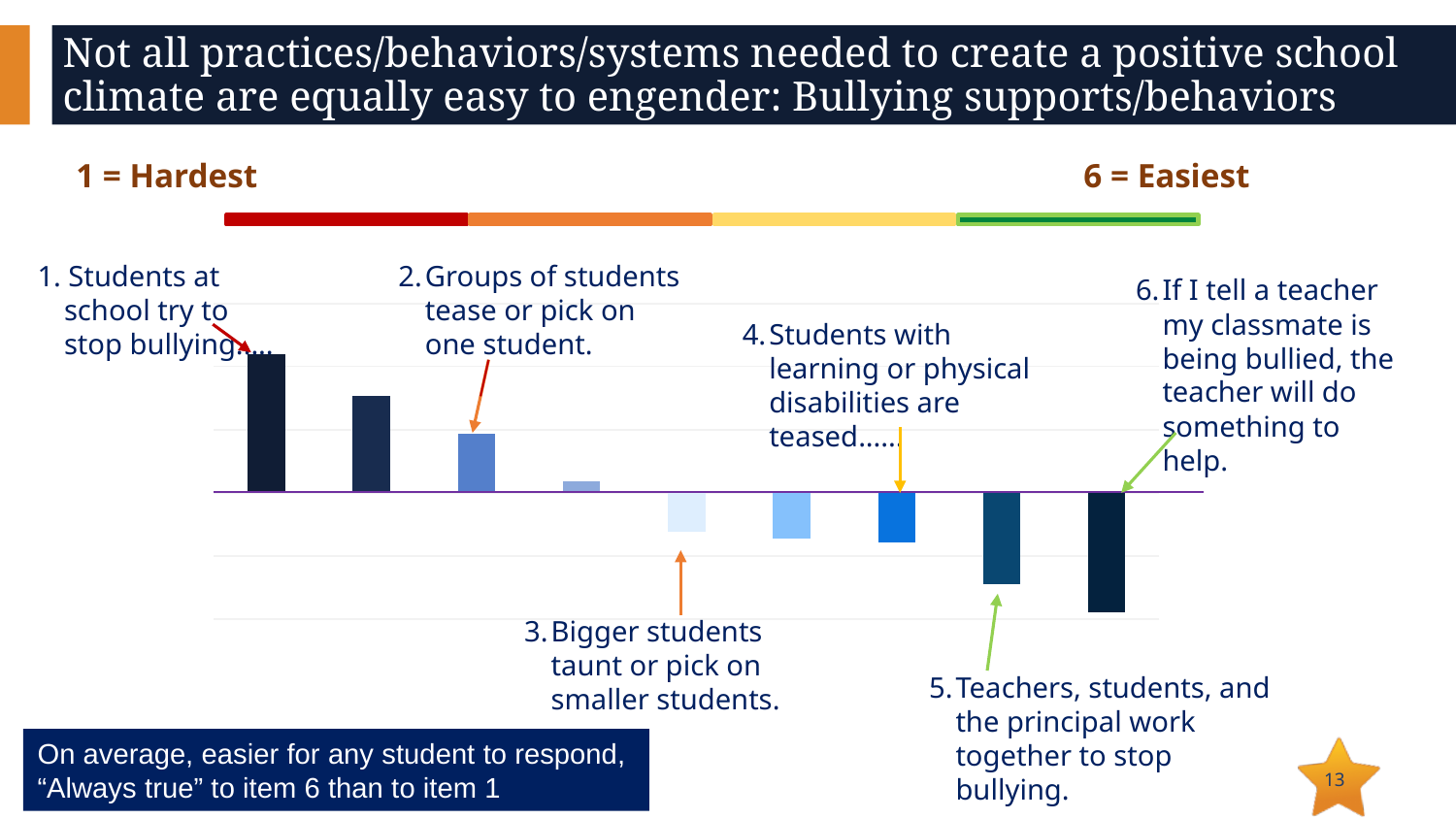
Which is larger, the bar for item 4 (Students with learning or physical disabilities are teased) or the bar for item 3 (Bigger students taunt or pick on smaller students)? item 3 How many bars are plotted in the chart? 9 How many bars extend above the horizontal axis line? 4 According to the scale labels above the chart, what does 6 represent? Easiest Which bar has the lowest value in the chart? the last (rightmost) bar, item 6 "If I tell a teacher my classmate is being bullied, the teacher will do something to help" What kind of chart is shown on the slide? bar chart Which bar has the highest value in the chart? the first (leftmost) bar, item 1 "Students at school try to stop bullying" According to the scale labels above the chart, what does 1 represent? Hardest How many bars extend below the horizontal axis line? 5 Which item does the slide say is easier, on average, for any student to respond "Always true" to: item 6 or item 1? item 6 Which is larger, the bar for item 1 (Students at school try to stop bullying) or the bar for item 2 (Groups of students tease or pick on one student)? item 1 Do the bar values rise or fall moving from left to right along the x axis? fall